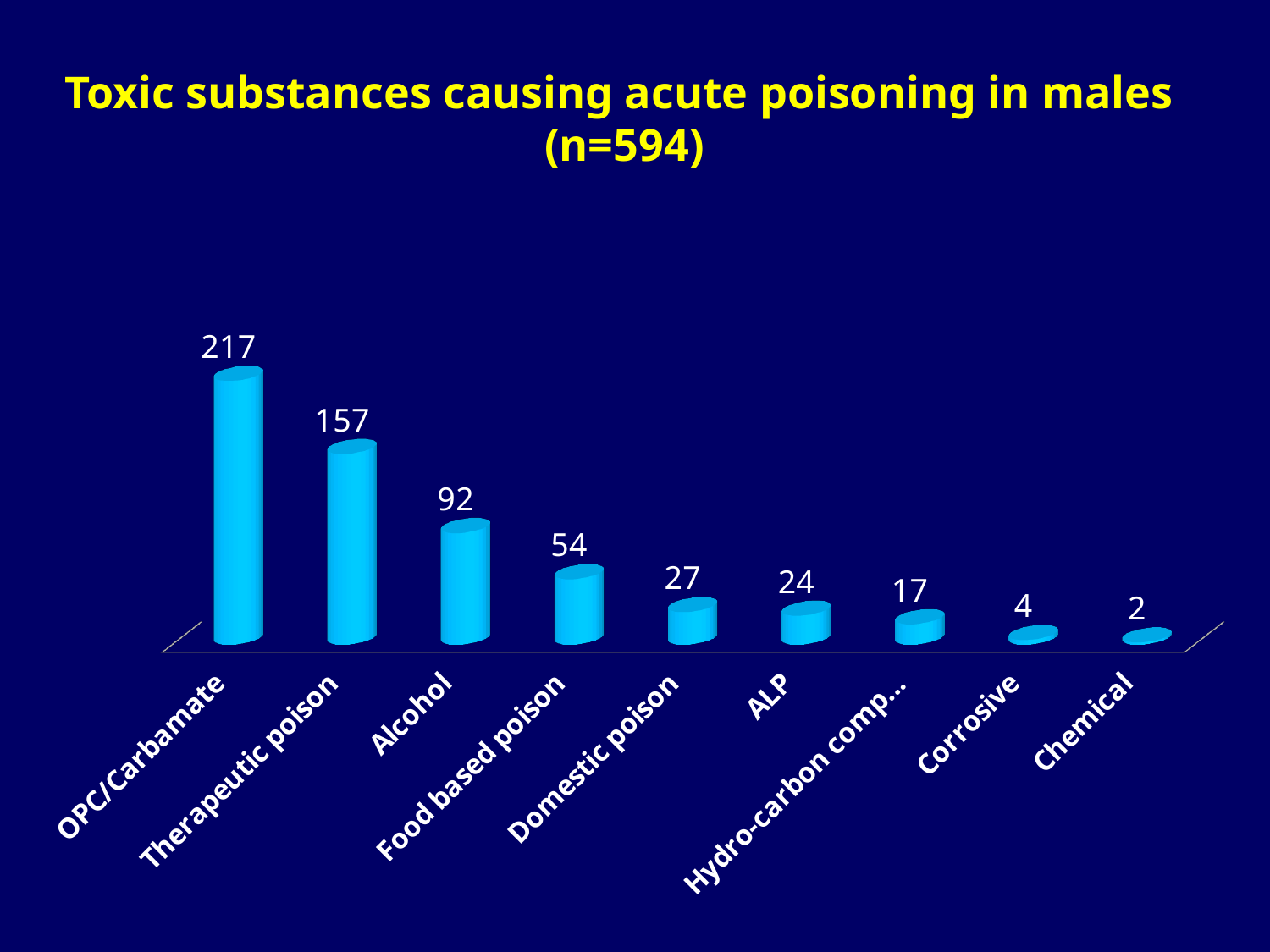
What is the difference between the values for Alcohol and Food based poison? 38 Which category has the highest value? OPC/Carbamate Which category has the lowest value? Chemical Which is larger, the value for ALP or the value for Domestic poison? Domestic poison What is the value for OPC/Carbamate? 217 What is the value for Alcohol? 92 How many categories are shown in the chart? 9 What is the value for Domestic poison? 27 What kind of chart is shown on the slide? Bar chart What is the value for Corrosive? 4 What is the difference between the values for OPC/Carbamate and Therapeutic poison? 60 Do the values rise or fall from left to right along the x axis? Fall